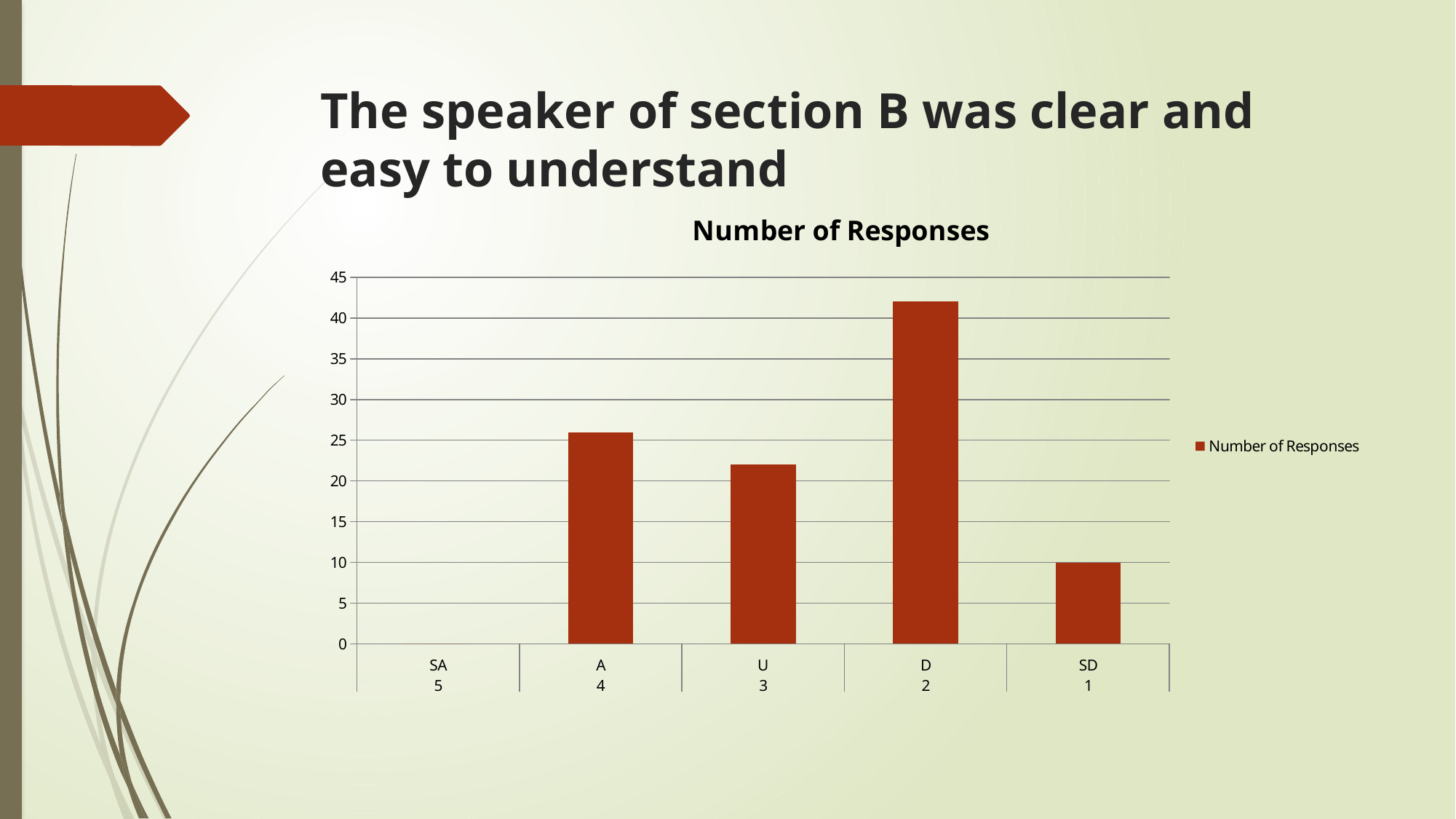
Is the number of responses for A greater or less than 25? greater Which category has the lowest number of responses? SA What is the number of responses for SA? 0 How many categories are shown on the x axis? 5 Which has more responses, A or U? A Is the number of responses for D greater or less than 40? greater How many series does the legend list? 1 Which category has the highest number of responses? D What is the number of responses for SD? 10 What is the title of the chart? Number of Responses What type of chart is shown on the slide? bar chart Is the number of responses for U greater or less than 25? less